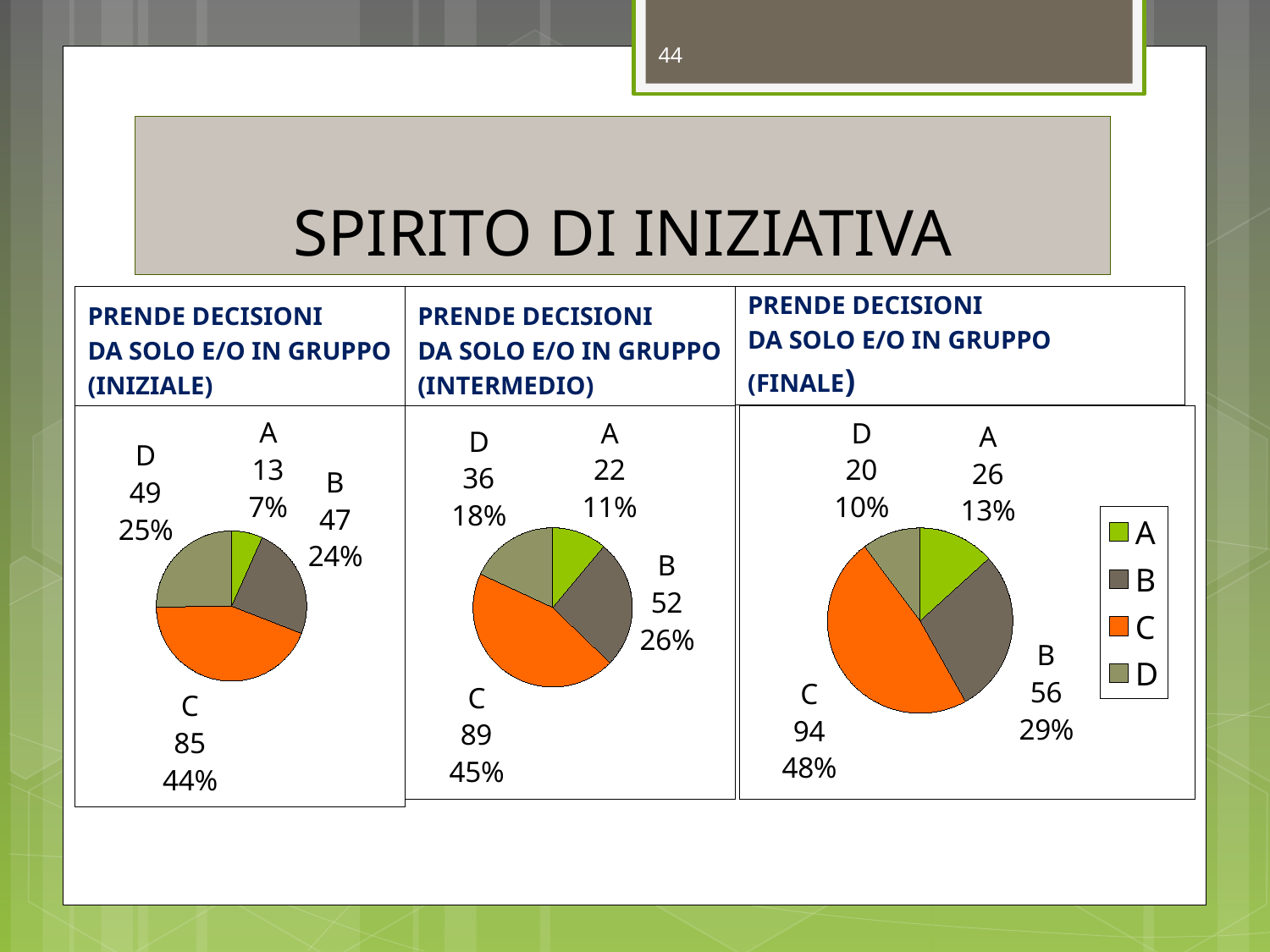
In the INTERMEDIO pie chart (middle), what percentage share does category B have? 26% In the FINALE pie chart (right), what is the difference between the values for C and B? 38 What type of chart is used in the INIZIALE panel (left)? Pie chart In the INIZIALE pie chart (left), which category has the smallest slice? A In the INIZIALE pie chart (left), what percentage share does category A have? 7% In the INIZIALE pie chart (left), what value is shown for category C? 85 In the INTERMEDIO pie chart (middle), which category has the largest slice? C In the FINALE pie chart (right), what value is shown for category B? 56 In the FINALE pie chart (right), what percentage share does category C have? 48% How many categories does the legend on the FINALE pie chart (right) list? 4 In the FINALE pie chart (right), which category has the smallest slice? D In the INTERMEDIO pie chart (middle), what value is shown for category D? 36